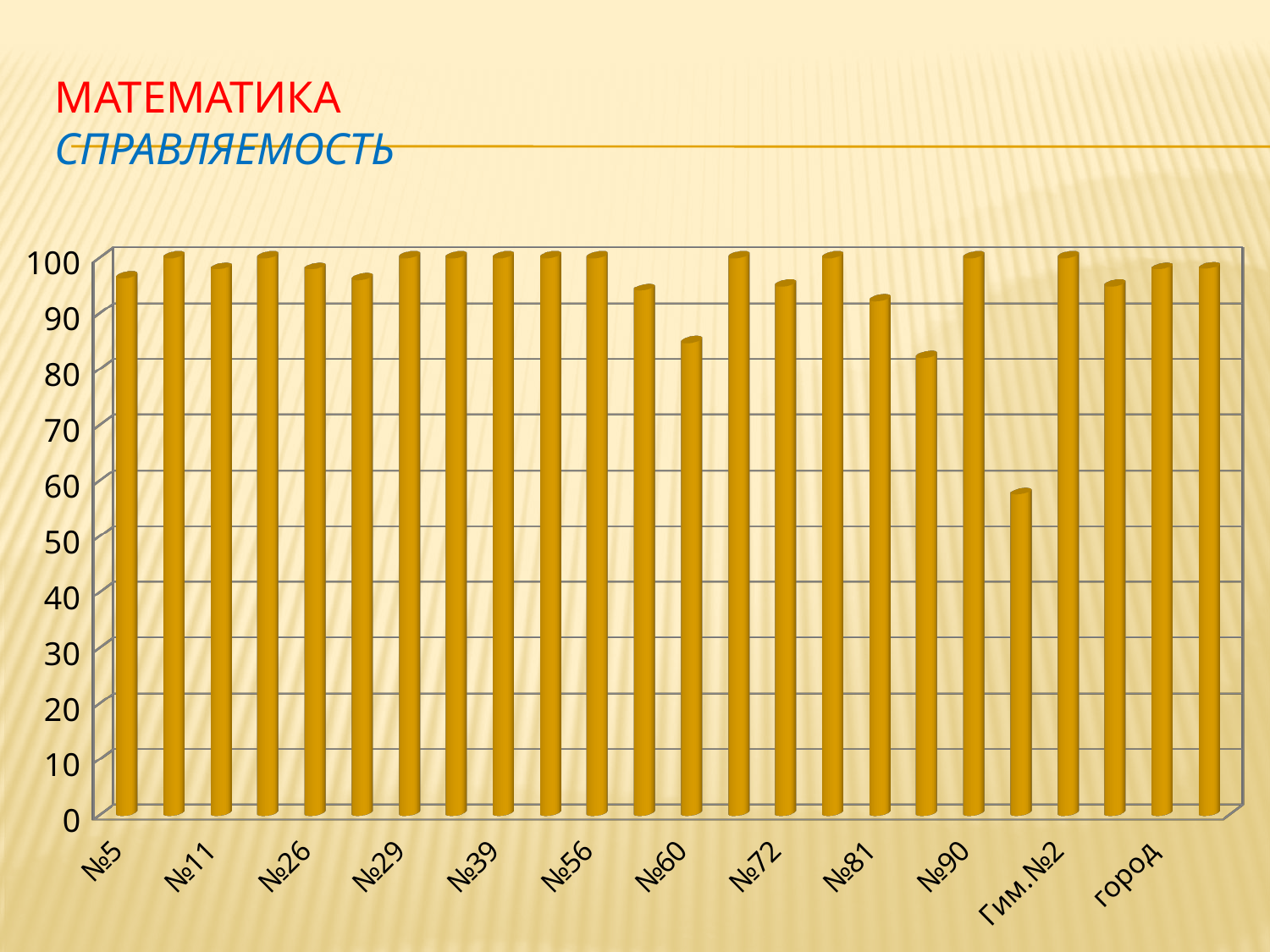
Is the value for №81 greater or less than 90? greater Do the values rise steadily, fall steadily, or fluctuate across the categories from left to right? fluctuate Is the value for город greater or less than 90? greater What subject is named in the slide title above the chart? Математика Is the lowest bar in the chart greater or less than 60? less How many bars are plotted in the chart? 24 What kind of chart is shown on the slide? bar chart Which is larger, the value for Гим.№2 or the value for №60? Гим.№2 Which is larger, the value for №60 or the value for №90? №90 What is the highest tick value shown on the vertical axis? 100